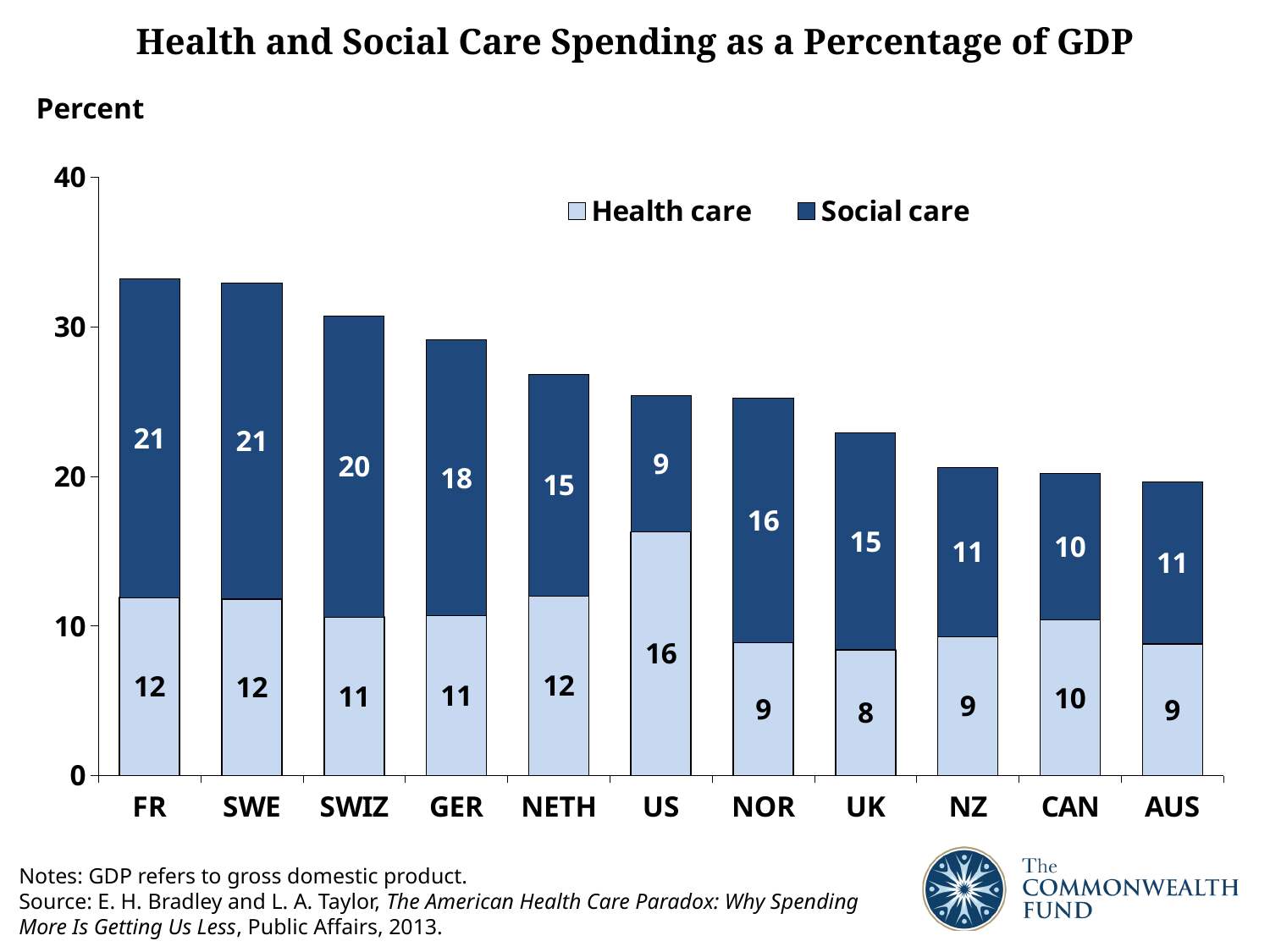
What is the social care spending value for NOR? 16 What kind of chart is shown on the slide? Stacked bar chart What is the title of the chart? Health and Social Care Spending as a Percentage of GDP Which country has the lowest health care spending value? UK What is the total of the stacked bar for GER? 29 What is the difference between social care and health care spending for FR? 9 Which country has the lowest social care spending value? US How many series does the legend list? 2 Which is larger, the health care value for the US or for NOR? US Which country has the highest health care spending value? US What is the health care spending value for the US? 16 How many countries are shown on the x axis? 11